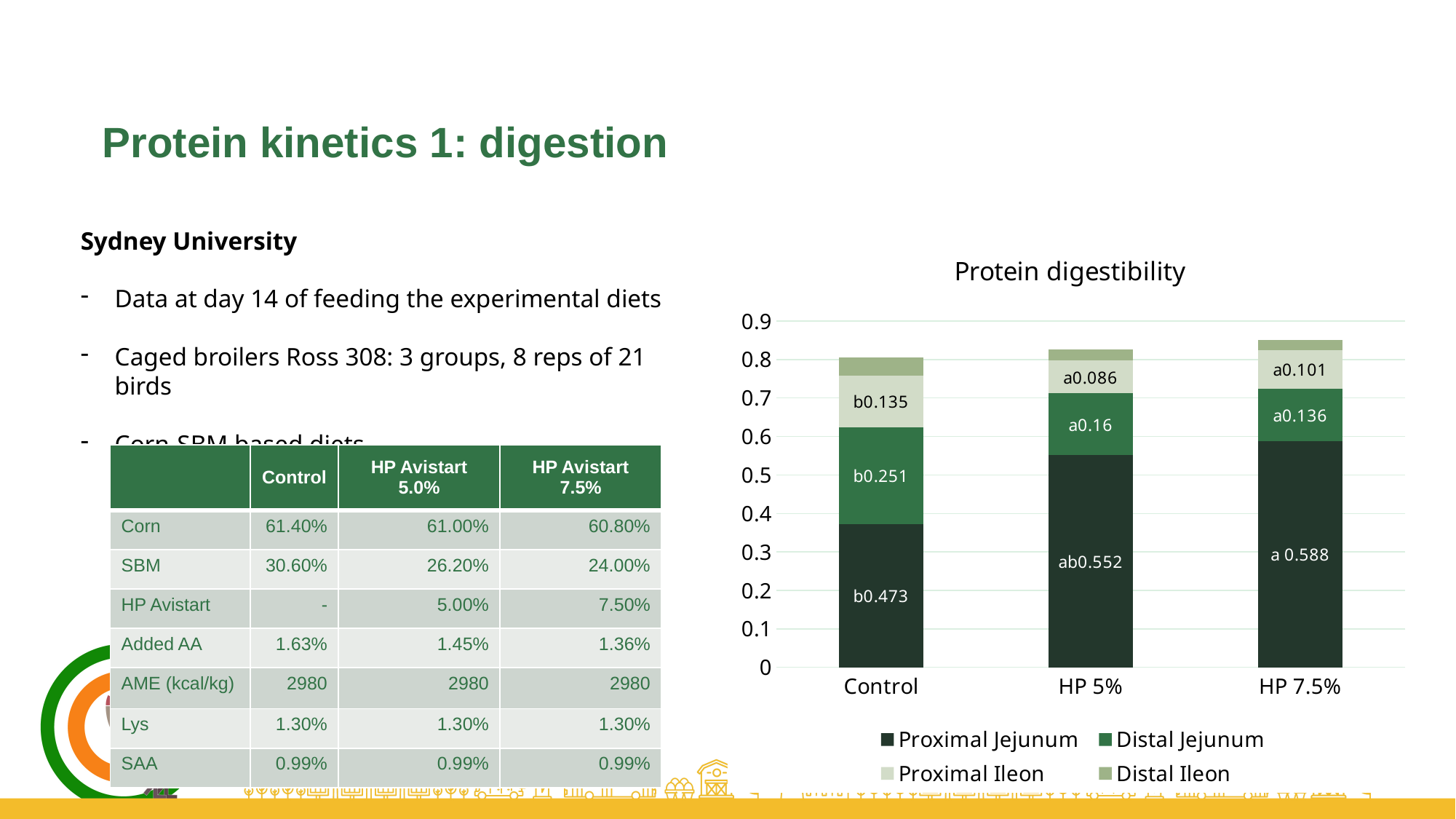
What is the Proximal Ileon value for HP 7.5%? 0.101 Is the total height of the HP 7.5% stacked bar greater or less than 0.8? greater Which has the larger Proximal Ileon value, Control or HP 5%? Control How many categories are shown on the x axis of the chart? 3 Which category has the lowest Distal Jejunum value? HP 7.5% What kind of chart is shown on the slide? Stacked bar chart Which category has the highest Proximal Jejunum value? HP 7.5% What is the title of the chart? Protein digestibility How many series does the chart legend list? 4 What is the Distal Jejunum value for HP 5%? 0.16